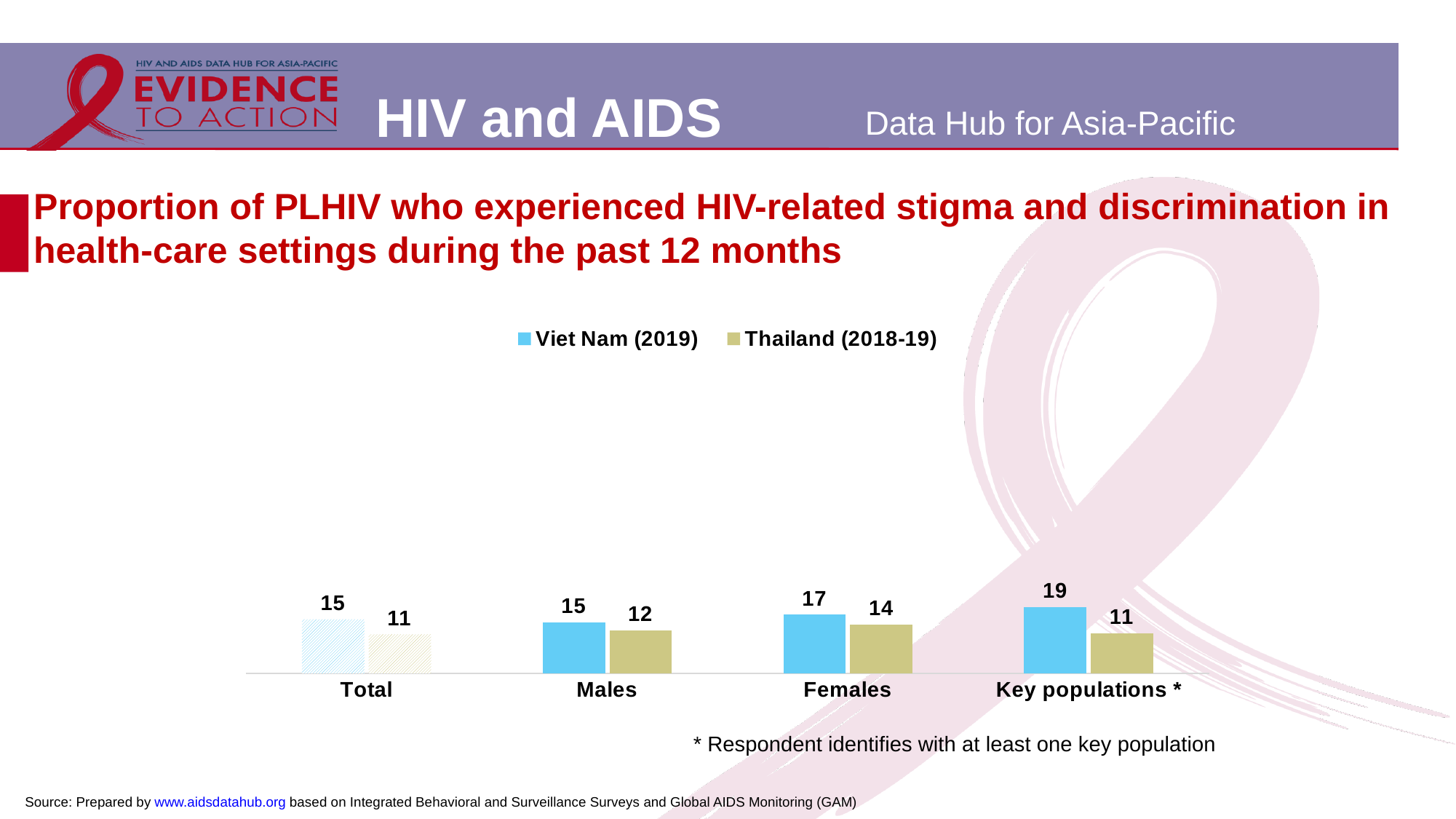
How many categories are shown on the x axis? 4 How many series does the legend list? 2 What is the value for Thailand (2018-19) in the Males category? 12 What is the value for Thailand (2018-19) in the Total category? 11 What is the difference between the Viet Nam (2019) and Thailand (2018-19) values for Key populations *? 8 Which is larger in the Females category: Viet Nam (2019) or Thailand (2018-19)? Viet Nam (2019) Which category has the highest value for Viet Nam (2019)? Key populations * Which category has the highest value for Thailand (2018-19)? Females What is the value for Viet Nam (2019) in the Females category? 17 Which series is shown in blue in the legend? Viet Nam (2019) What is the value for Viet Nam (2019) in the Key populations * category? 19 What kind of chart is shown on the slide? Bar chart